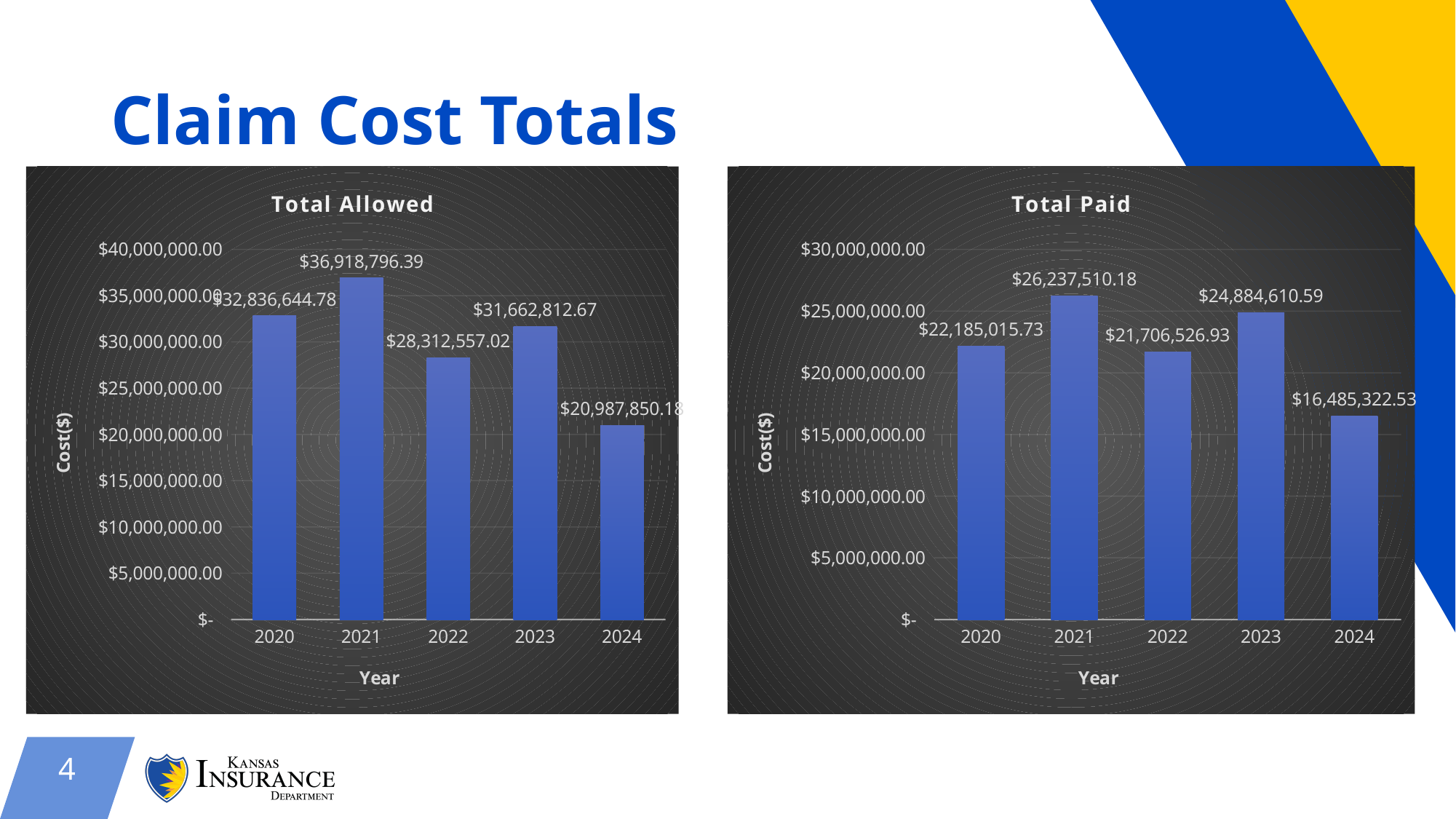
In the Total Allowed chart, which year has the highest value? 2021 In the Total Allowed chart, what is the difference between the 2021 and 2024 values? $15,930,946.21 In the Total Paid chart, what is the value for 2020? $22,185,015.73 In the Total Paid chart, which year has the lowest value? 2024 In the Total Allowed chart, what is the value for 2021? $36,918,796.39 What kind of chart is the Total Allowed chart? bar chart In the Total Paid chart, what is the value for 2024? $16,485,322.53 In the Total Paid chart, which is larger, the value for 2020 or the value for 2023? 2023 How many years are shown on the x axis of the Total Paid chart? 5 In the Total Allowed chart, is the value for 2024 greater or less than $25,000,000.00? less In the Total Allowed chart, what is the value for 2022? $28,312,557.02 In the Total Paid chart, what is the difference between the 2021 and 2022 values? $4,530,983.25